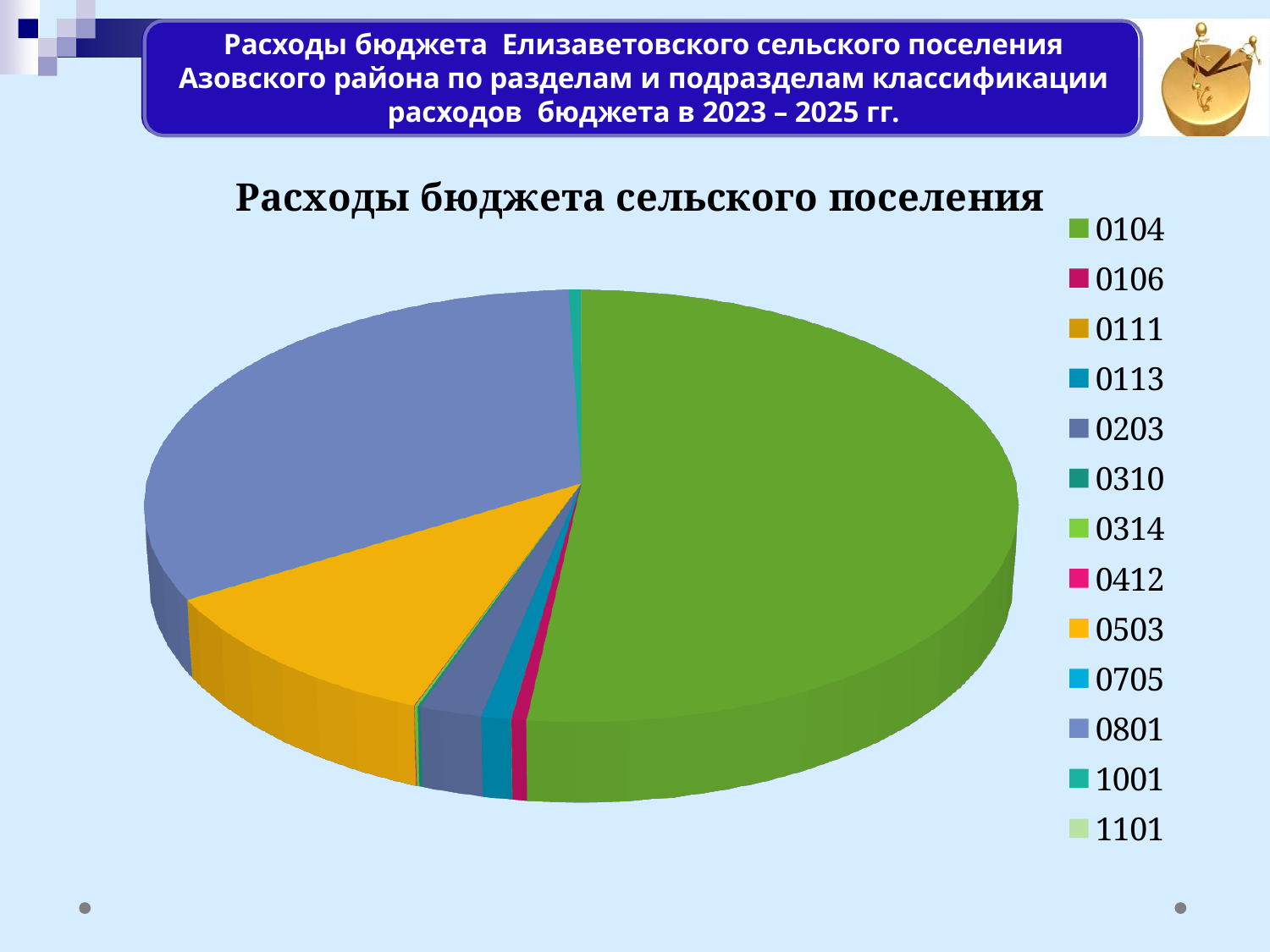
Which category has the largest slice of the pie? 0104 What is the first category listed in the legend? 0104 How many categories does the chart legend list? 13 Which slice is larger, 0801 or 0412? 0801 Which slice is larger, 0801 or 0503? 0801 Which slice is larger, 0104 or 0801? 0104 What is the title of the chart? Расходы бюджета сельского поселения What kind of chart is shown on the slide? pie chart